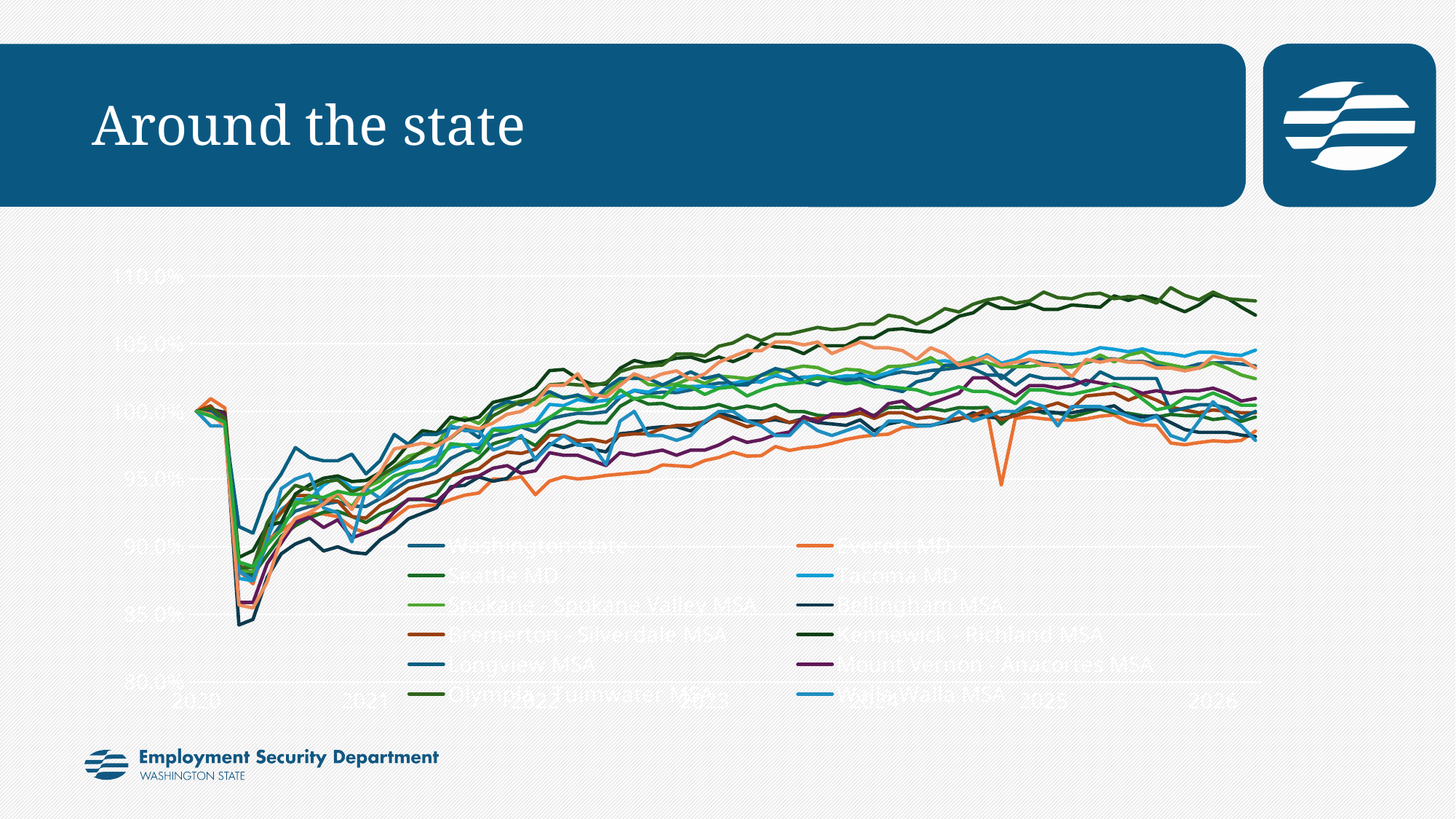
What is the lowest value shown on the vertical axis? 80.0% Is the highest value reached by any series near 2026 greater or less than 105.0%? greater What is the highest value shown on the vertical axis? 110.0% What value do all the series start at in 2020? 100.0% What kind of chart is shown on the slide? line chart How many series does the chart's legend list? 12 Is the lowest value reached by any series during the 2020 dip greater or less than 90.0%? less After the sharp drop in 2020, do the series generally rise or fall through 2026? rise What is the title of the slide containing the chart? Around the state Which year on the horizontal axis is the first label shown? 2020 How many year labels appear along the horizontal axis? 7 Which series in the legend is drawn in orange? Everett MD